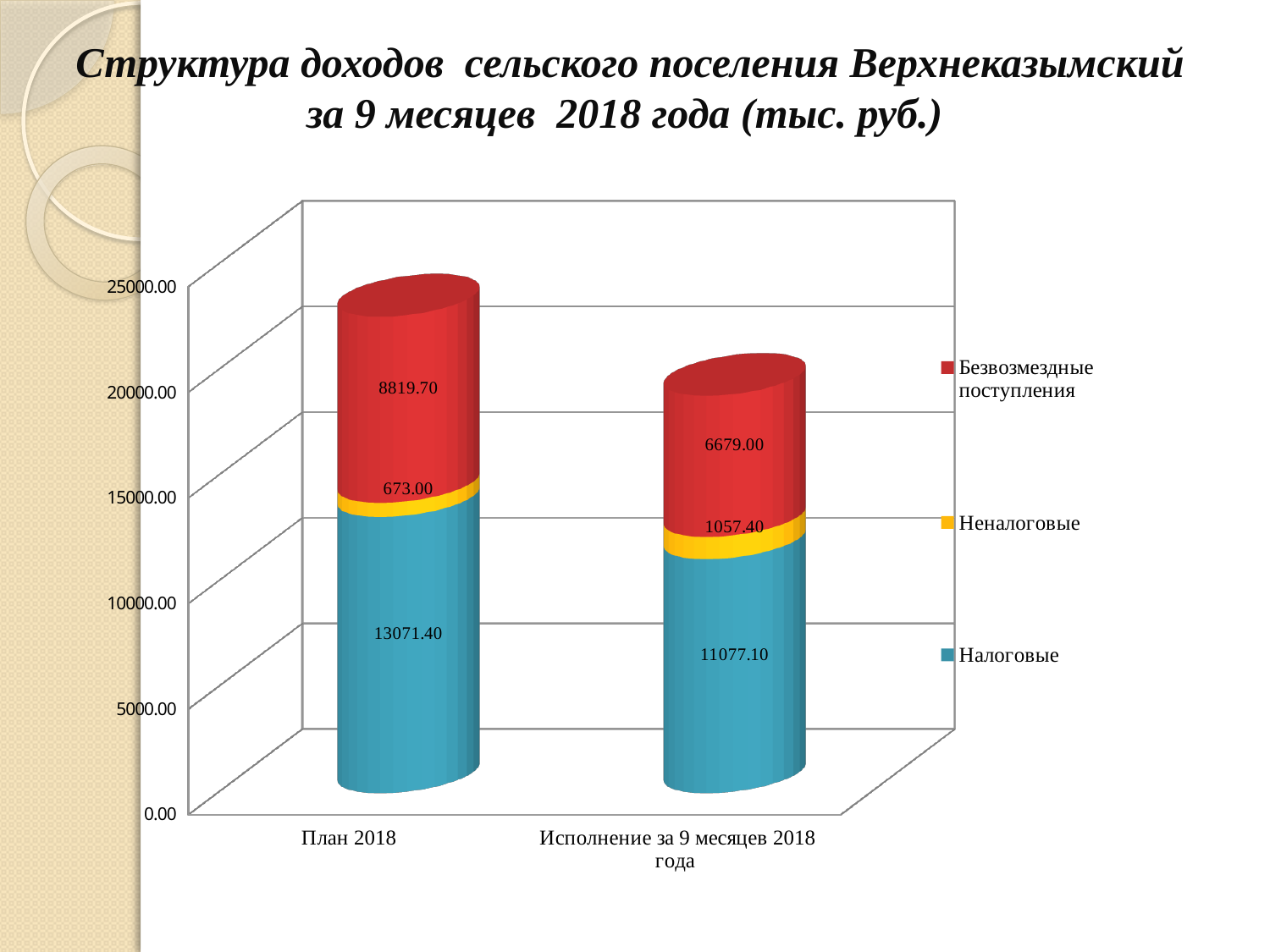
What is the value of Неналоговые for Исполнение за 9 месяцев 2018 года? 1057.40 What is the value of Неналоговые for План 2018? 673.00 What is the value of Налоговые for План 2018? 13071.40 What is the difference between the Безвозмездные поступления values for План 2018 and Исполнение за 9 месяцев 2018 года? 2140.70 What kind of chart is shown on the slide? Stacked bar chart What is the total of the stacked bar for Исполнение за 9 месяцев 2018 года? 18813.50 What is the total of the stacked bar for План 2018? 22564.10 What is the difference between the Налоговые values for План 2018 and Исполнение за 9 месяцев 2018 года? 1994.30 What is the value of Безвозмездные поступления for Исполнение за 9 месяцев 2018 года? 6679.00 Which category has the higher value for Налоговые, План 2018 or Исполнение за 9 месяцев 2018 года? План 2018 How many series does the legend list? 3 Which series has the lowest value in the План 2018 bar? Неналоговые